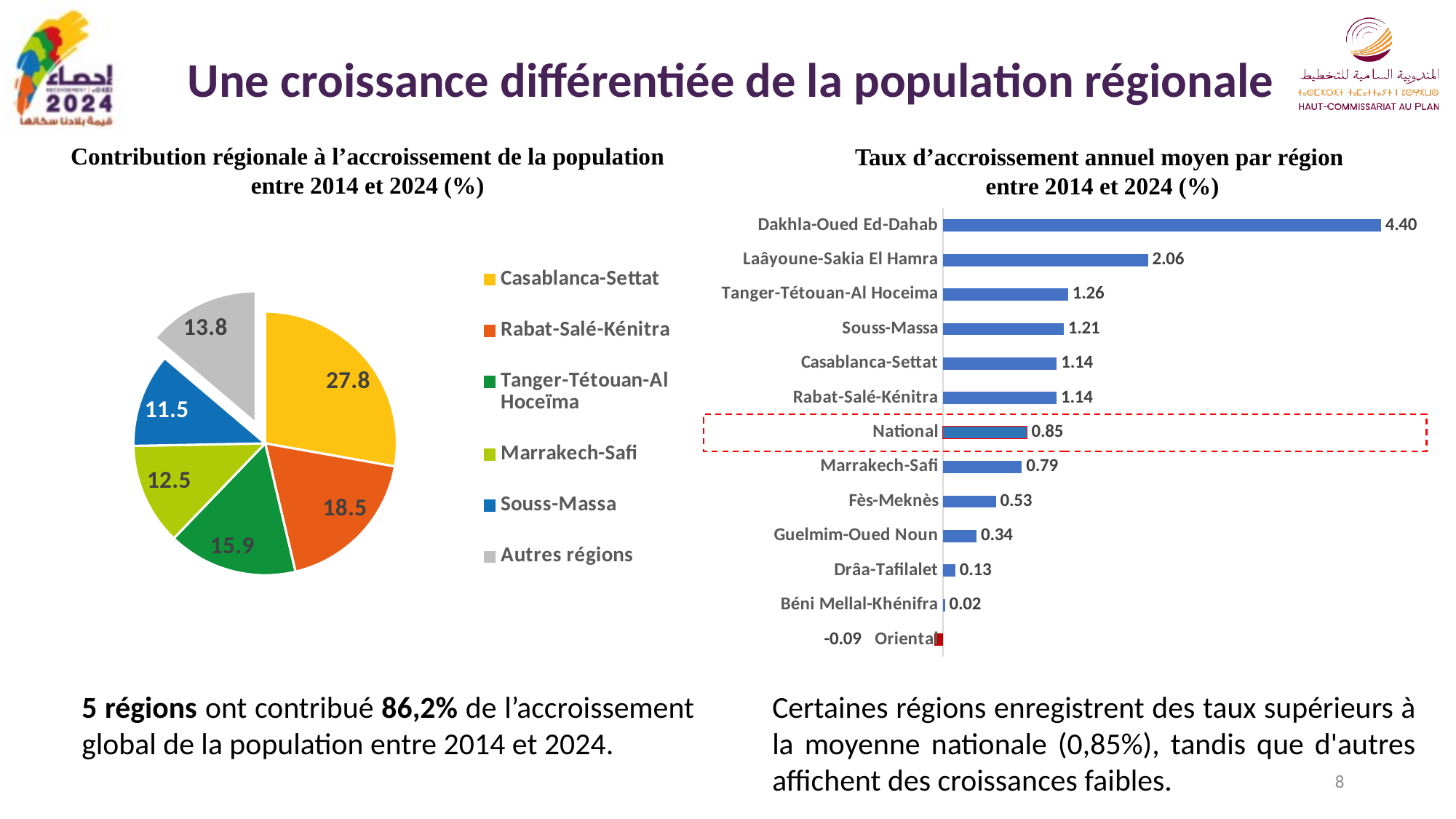
In the pie chart on the left, which region has the largest slice? Casablanca-Settat In the pie chart on the left, what is the value for Souss-Massa? 11.5 In the bar chart on the right, what is the value for National? 0.85 In the bar chart on the right, what is the difference between the values for Laâyoune-Sakia El Hamra and Souss-Massa? 0.85 In the pie chart on the left, how many slices are there? 6 In the pie chart on the left, which colour represents Autres régions? Grey In the bar chart 'Taux d'accroissement annuel moyen par région entre 2014 et 2024 (%)', what is the value for Dakhla-Oued Ed-Dahab? 4.40 In the pie chart 'Contribution régionale à l'accroissement de la population entre 2014 et 2024 (%)', what is the value for Casablanca-Settat? 27.8 In the bar chart on the right, which is larger: the value for Fès-Meknès or the value for Guelmim-Oued Noun? Fès-Meknès In the pie chart on the left, what is the difference between the values for Rabat-Salé-Kénitra and Marrakech-Safi? 6.0 In the bar chart on the right, which region has the lowest value? Oriental What type of chart is shown on the right side of the slide? Bar chart